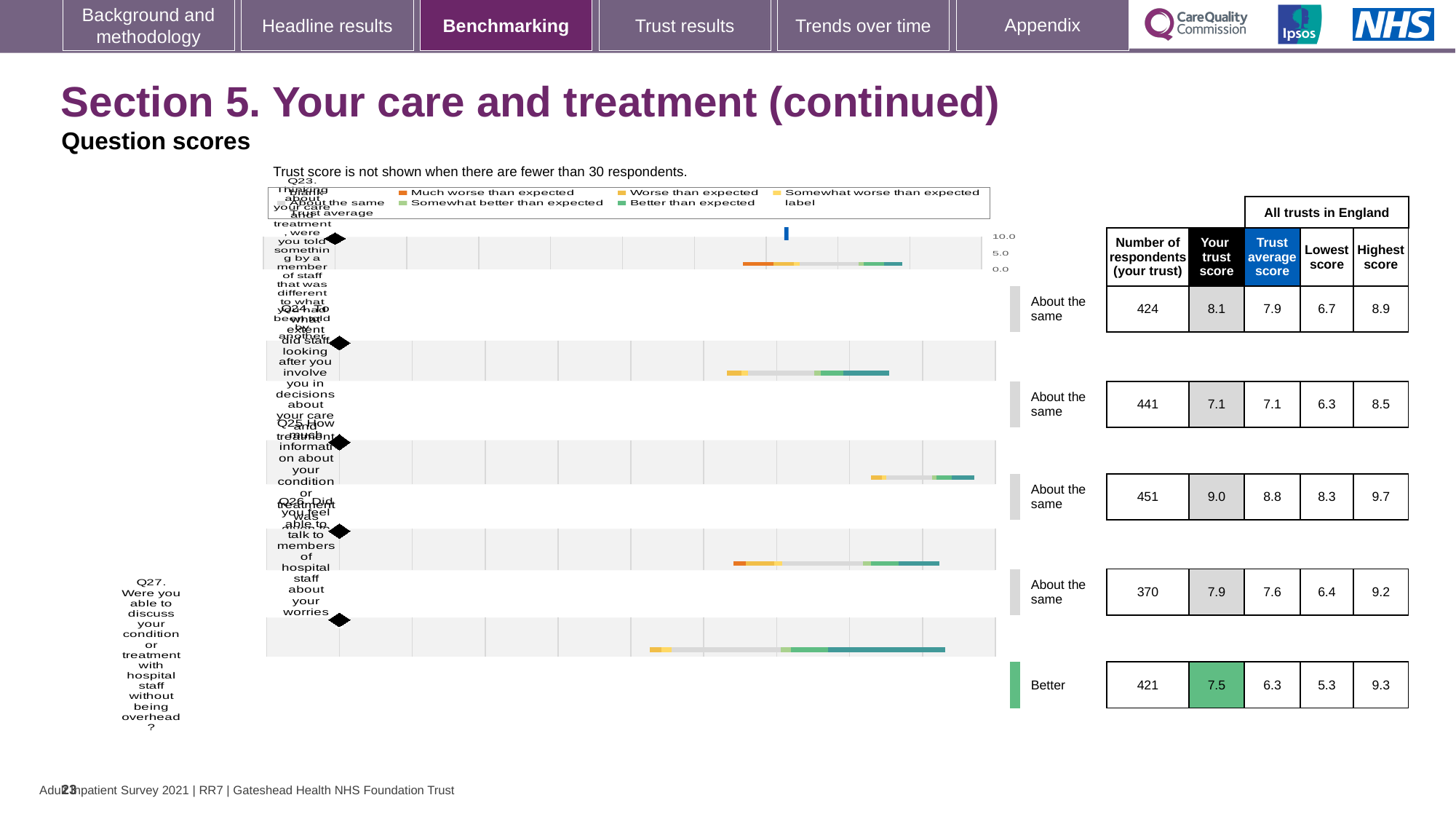
Which question has the lowest trust score for this trust? Q24 Which question is rated 'Better' rather than 'About the same'? Q27 Which question has the highest trust score for this trust? Q25 Is this trust's score for Q23 higher or lower than the trust average score for Q23? higher What is the trust score for Q27 (discussing your condition or treatment without being overheard)? 7.5 What is the highest score across all trusts in England for Q26? 9.2 How many respondents answered Q24 at this trust? 441 What is the trust average score for Q25? 8.8 What is the maximum value shown on the chart's score axis? 10.0 What is the difference between this trust's score and the trust average score for Q27? 1.2 How many questions are plotted on the chart? 5 What is the lowest score across all trusts in England for Q27? 5.3